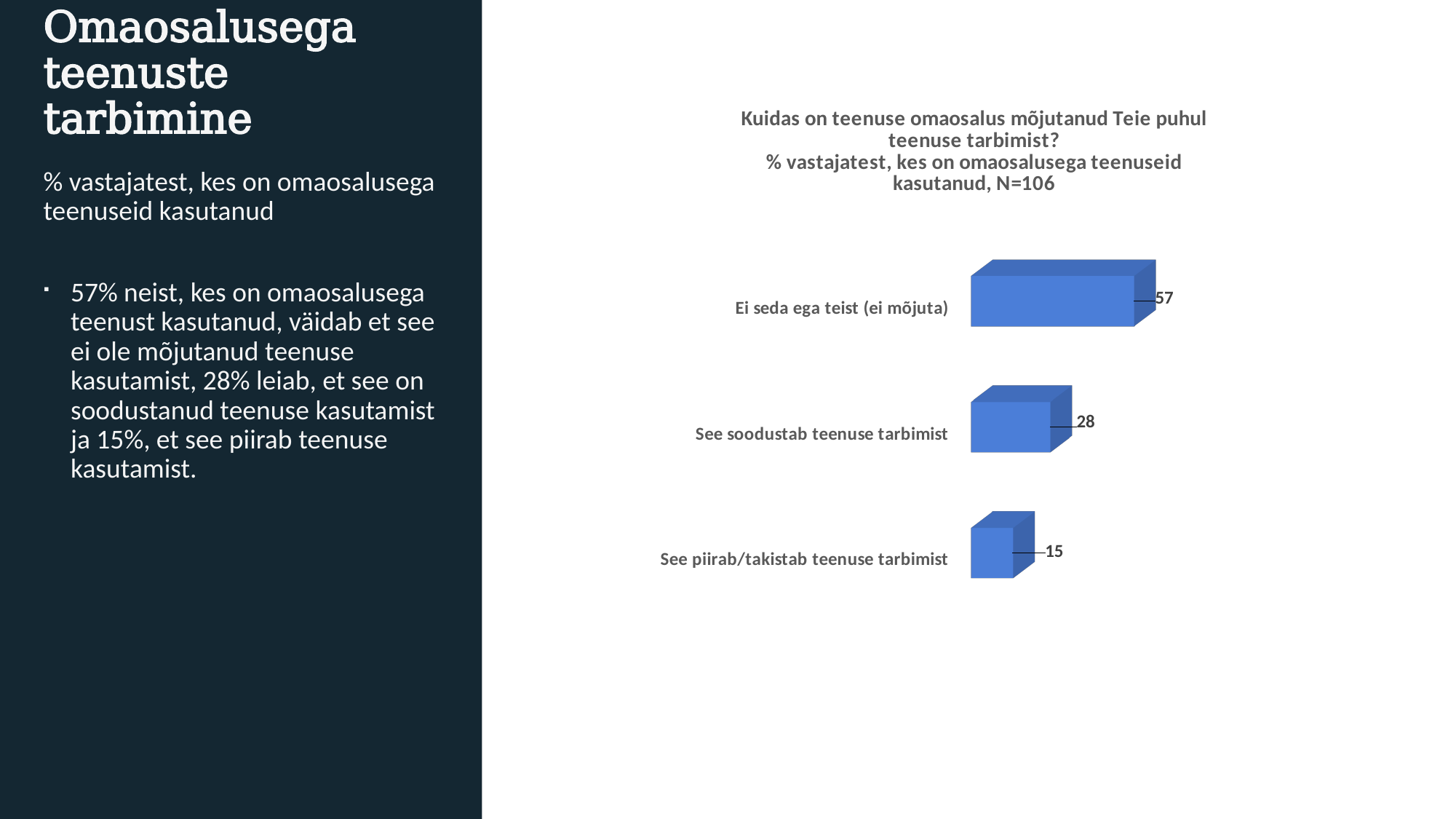
Which category has the highest value? Ei seda ega teist (ei mõjuta) What kind of chart is shown on the slide? Bar chart What is the value for "Ei seda ega teist (ei mõjuta)"? 57 What is the value for "See piirab/takistab teenuse tarbimist"? 15 What is the difference between the values for "See soodustab teenuse tarbimist" and "See piirab/takistab teenuse tarbimist"? 13 What is the value for "See soodustab teenuse tarbimist"? 28 Which is larger: the value for "See soodustab teenuse tarbimist" or "See piirab/takistab teenuse tarbimist"? See soodustab teenuse tarbimist What is the difference between the values for "Ei seda ega teist (ei mõjuta)" and "See soodustab teenuse tarbimist"? 29 How many categories are shown in the chart? 3 Which category has the lowest value? See piirab/takistab teenuse tarbimist What is the total of the three values shown in the chart? 100 What is the N (number of respondents) stated in the chart title? N=106